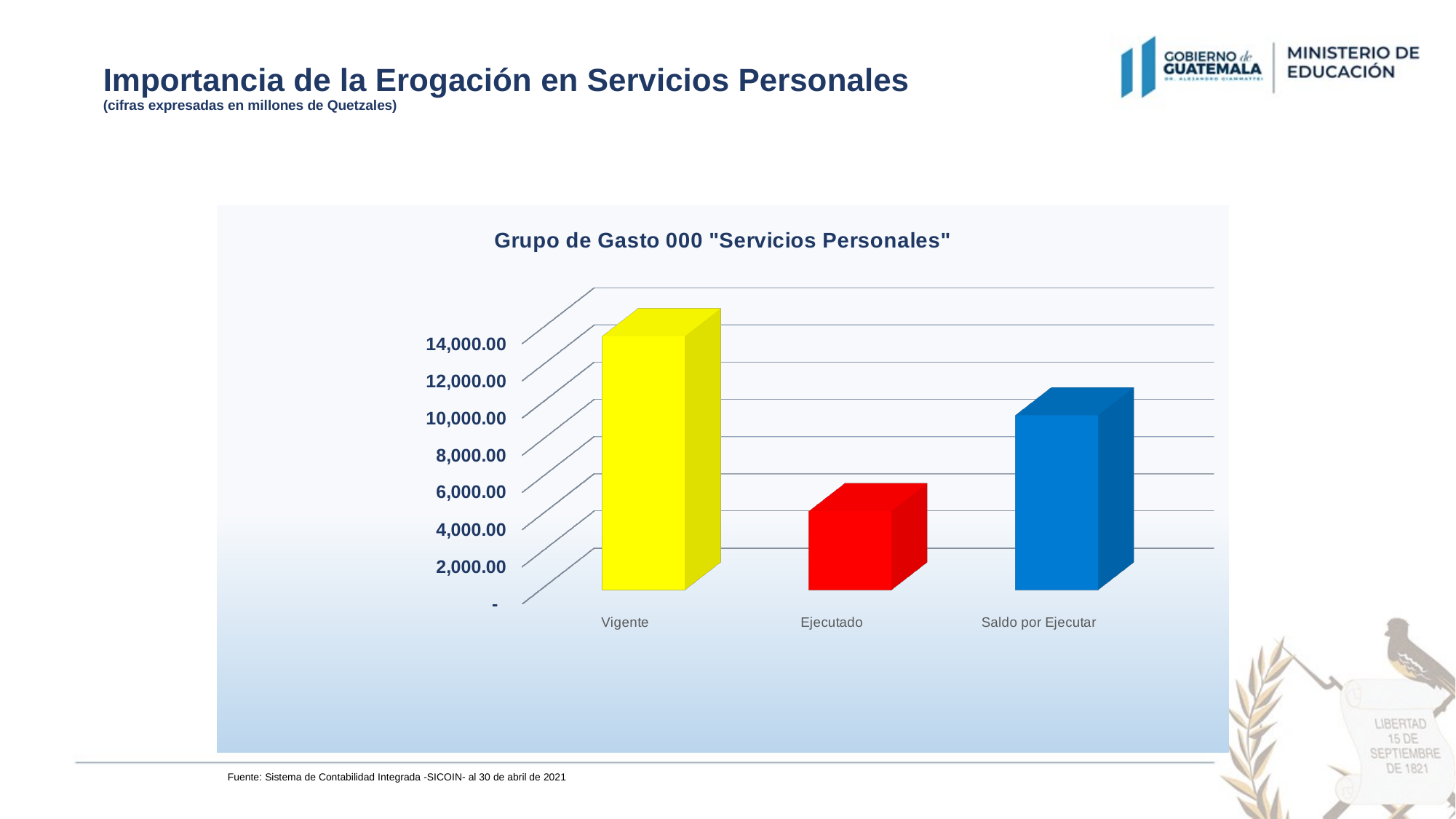
Which is larger, the value for Saldo por Ejecutar or the value for Ejecutado? Saldo por Ejecutar Which category has the lowest value? Ejecutado Is the value for Ejecutado greater or less than 6,000.00? less What type of chart is shown on the slide? bar chart How many categories are plotted in the chart? 3 Is the value for Vigente greater or less than 12,000.00? greater What colour is the bar for Ejecutado? red What is the title of the chart? Grupo de Gasto 000 "Servicios Personales" Is the value for Ejecutado greater or less than 2,000.00? greater Which category has the highest value? Vigente